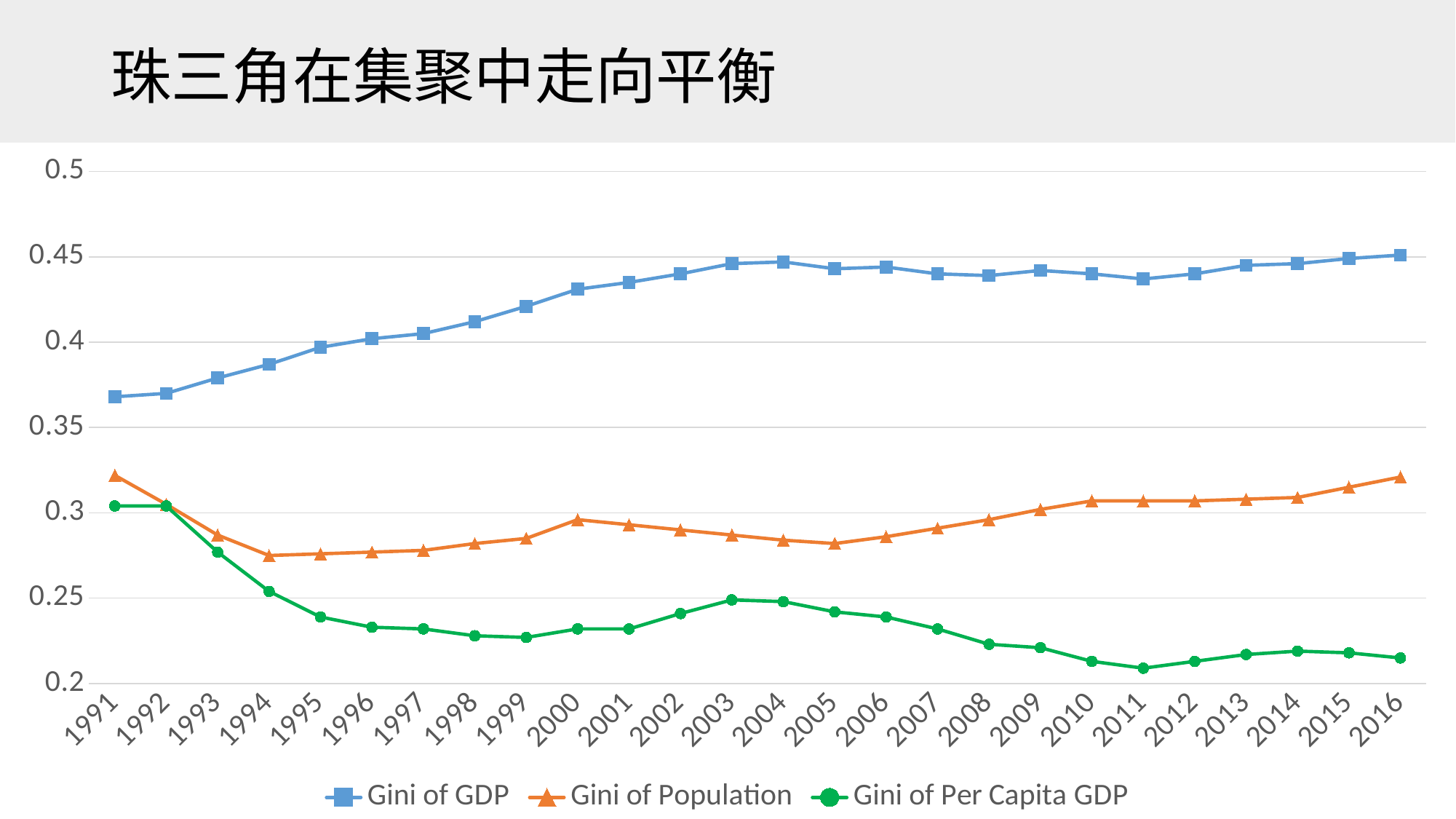
How many series does the legend list? 3 In which year is the Gini of Per Capita GDP at its lowest? 2011 Which marker shape is used for the Gini of Population series? Triangles How many years are plotted along the x axis? 26 Is the value of Gini of Per Capita GDP in 2011 greater or less than 0.25? less In 2016, which is higher: Gini of Population or Gini of Per Capita GDP? Gini of Population Is the value of Gini of GDP in 2016 greater or less than 0.4? greater Does the Gini of Per Capita GDP series rise or fall overall from 1991 to 2016? Fall Is the value of Gini of GDP in 1991 greater or less than 0.4? less Does the Gini of GDP series rise or fall overall from 1991 to 2016? Rise What kind of chart is shown on the slide? Line chart